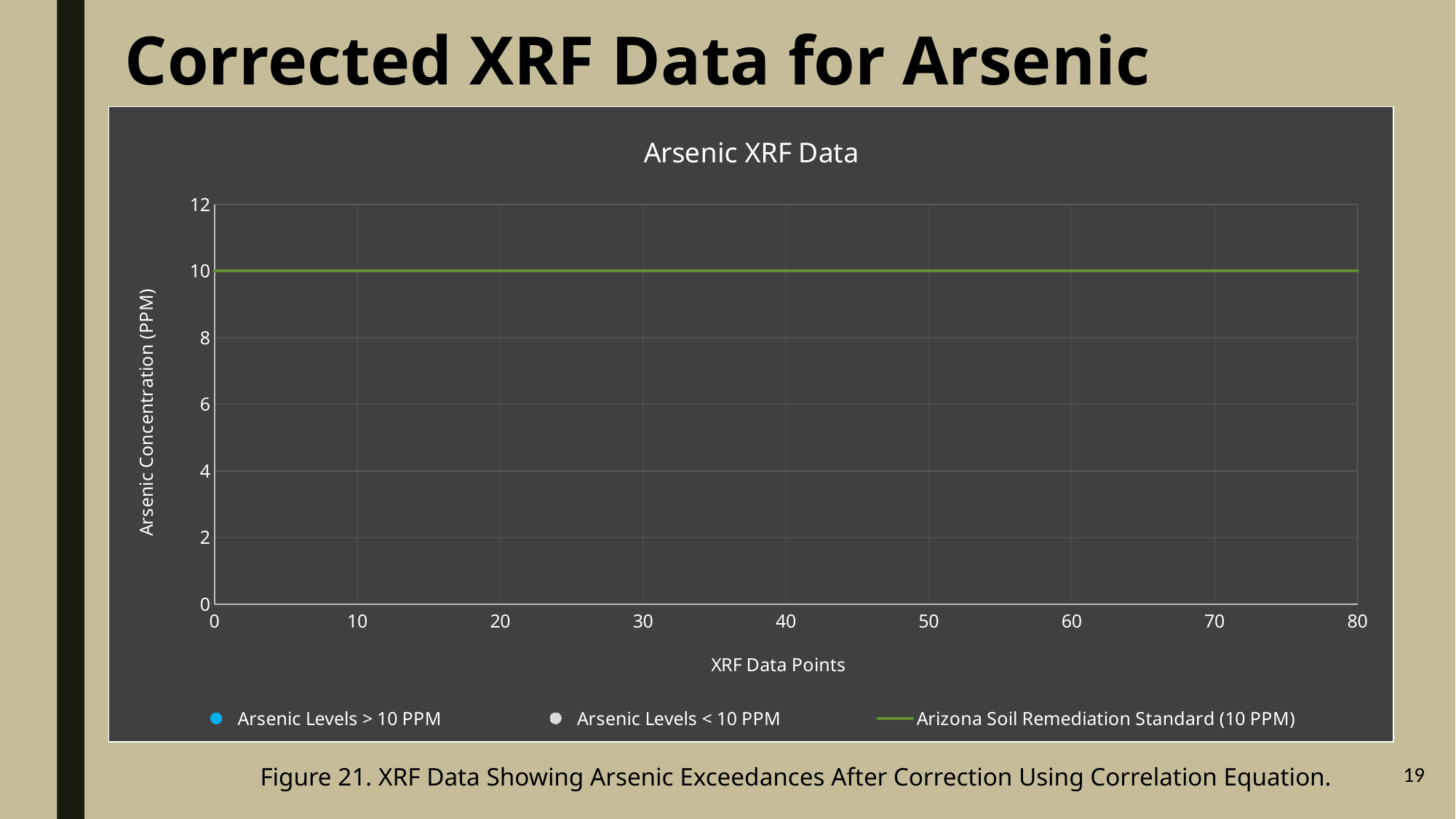
What is the highest value shown on the x axis? 80 What is the label of the y axis? Arsenic Concentration (PPM) Is the value of the Arizona Soil Remediation Standard line greater or less than 8? greater What is the value of the Arizona Soil Remediation Standard line on the y axis? 10 Does the Arizona Soil Remediation Standard line rise, fall, or stay flat across the x axis? stays flat How many series does the legend list? 3 What is the title of the chart? Arsenic XRF Data Is the value of the Arizona Soil Remediation Standard line greater or less than 12? less What is the highest value shown on the y axis? 12